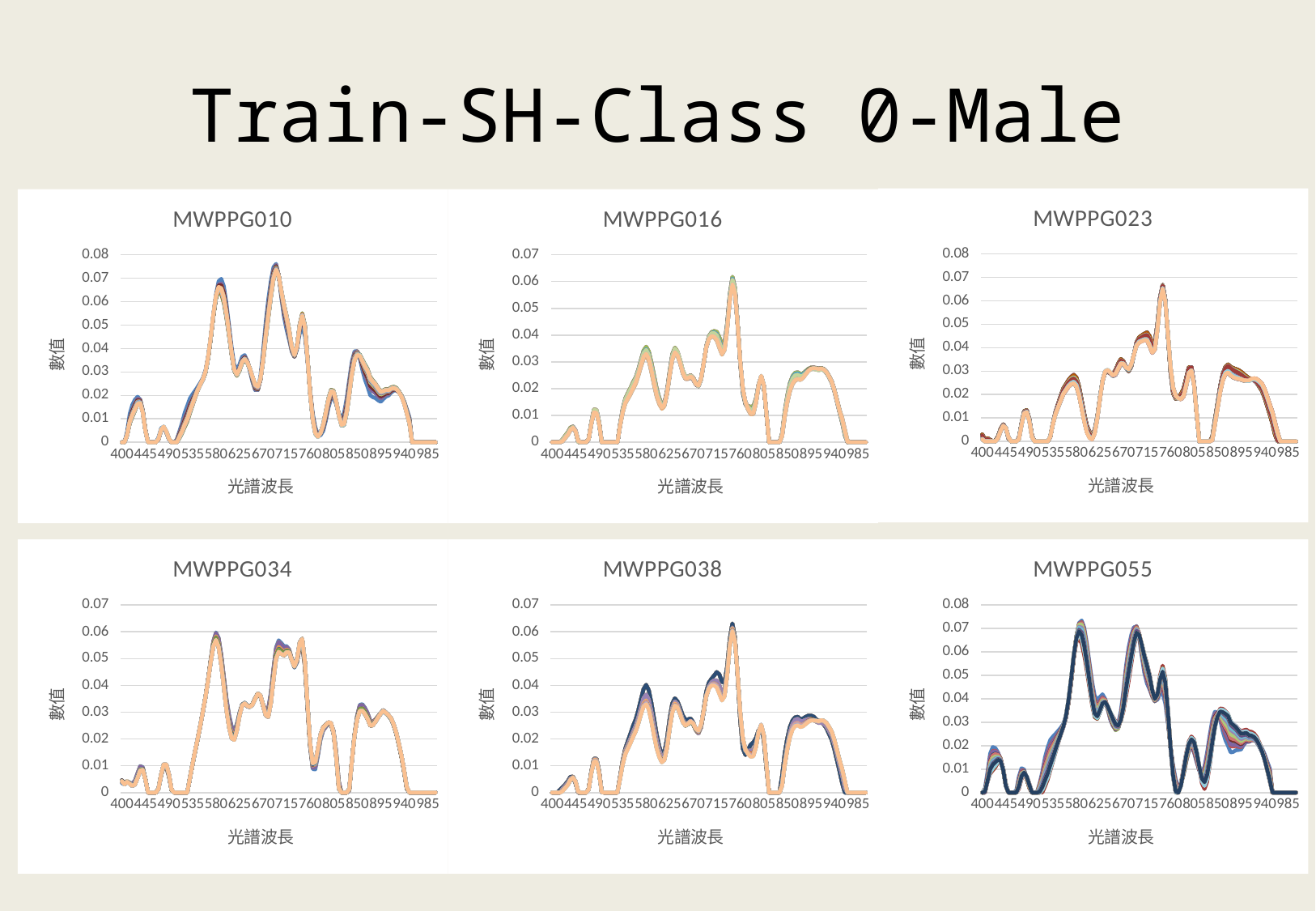
In the MWPPG038 chart, is the highest peak (near 760) greater or less than 0.05? greater In the MWPPG023 chart, is the highest peak (near 760) greater or less than 0.06? greater What is the title of the chart in the bottom-right position of the slide? MWPPG055 How many charts are shown on the slide? 6 What is the first tick value on the x-axis of the MWPPG023 chart? 400 In the MWPPG016 chart, is the highest peak (near 760) greater or less than 0.05? greater What is the highest tick value on the y-axis of the MWPPG034 chart? 0.07 What kind of chart is the MWPPG010 chart? line chart